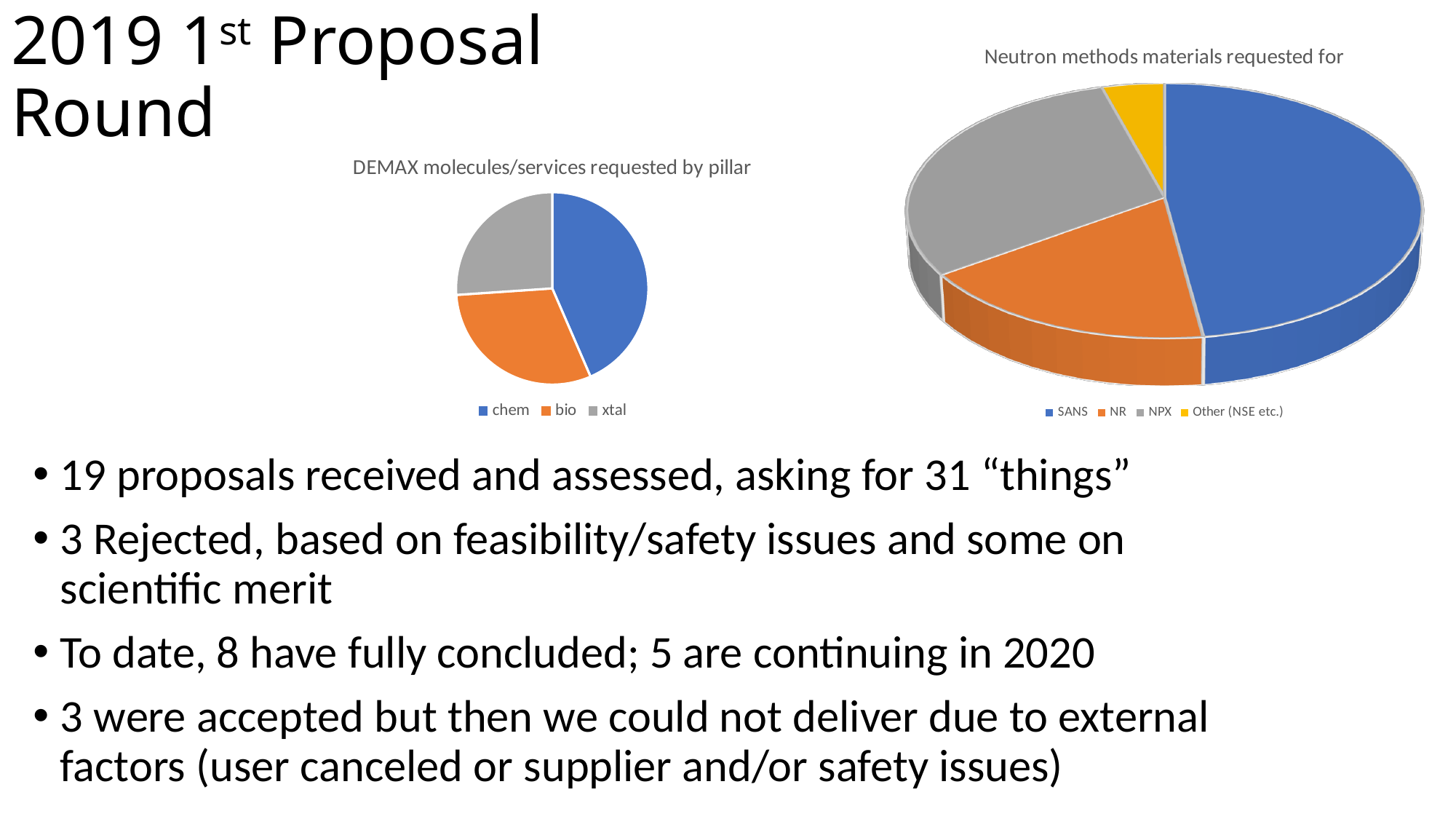
In the 'Neutron methods materials requested for' chart, which slice is larger, NPX or Other (NSE etc.)? NPX In the 'Neutron methods materials requested for' chart, which category has the smallest slice? Other (NSE etc.) In the 'Neutron methods materials requested for' chart, how many categories does the legend list? 4 What kind of chart is the 'Neutron methods materials requested for' chart? pie chart In the 'Neutron methods materials requested for' chart, which method has the largest slice? SANS In the 'DEMAX molecules/services requested by pillar' chart, what colour is the bio slice? orange What kind of chart is the 'DEMAX molecules/services requested by pillar' chart? pie chart In the 'DEMAX molecules/services requested by pillar' chart, how many slices does the pie have? 3 What is the title of the pie chart on the right side of the slide? Neutron methods materials requested for In the 'DEMAX molecules/services requested by pillar' chart, which pillar has the largest slice? chem In the 'Neutron methods materials requested for' chart, which slice is larger, SANS or NR? SANS In the 'DEMAX molecules/services requested by pillar' chart, which slice is larger, chem or xtal? chem